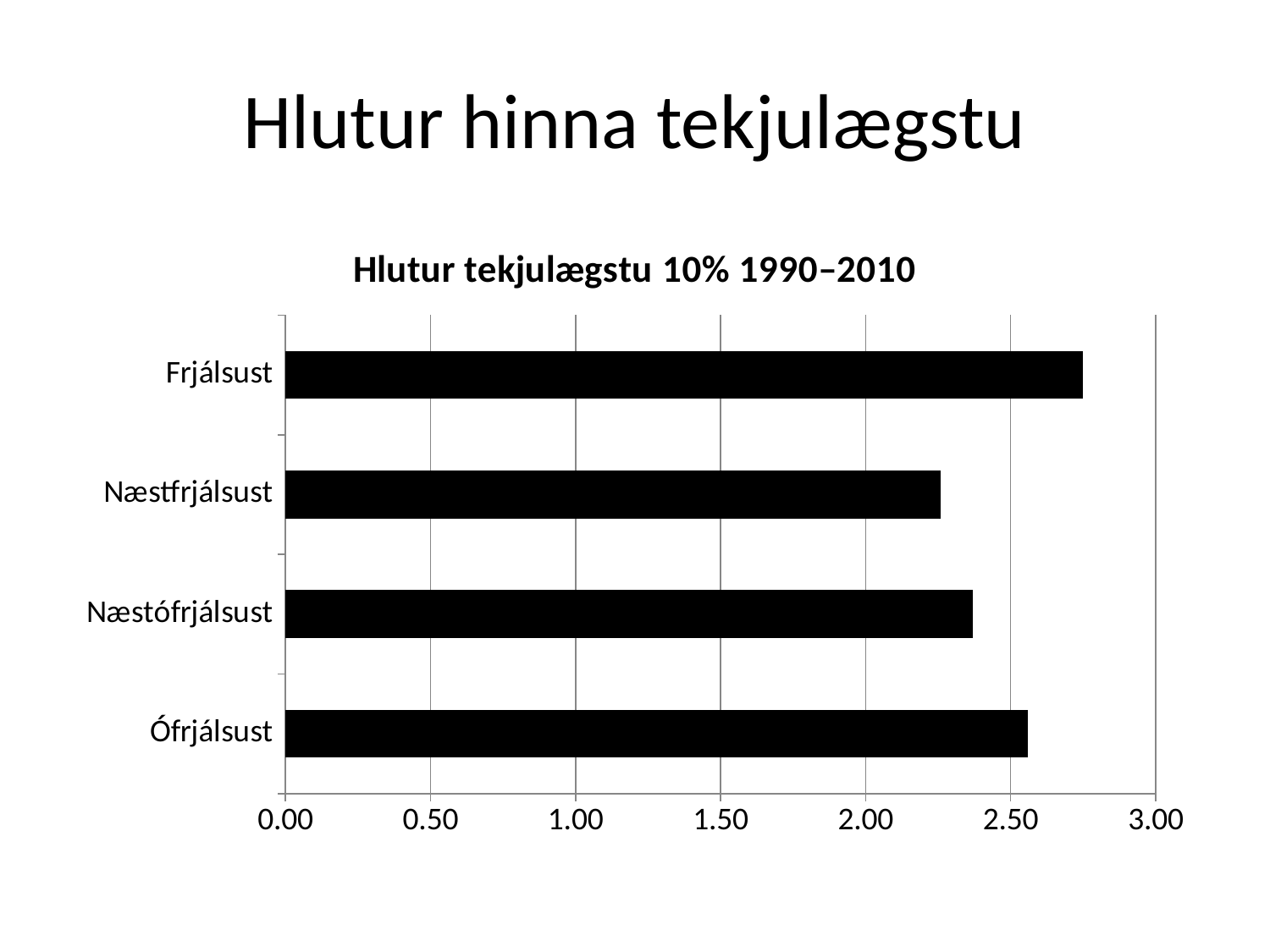
Which category has the lowest value? Næstfrjálsust Is the value for Ófrjálsust greater or less than 2.00? greater Is the value for Næstófrjálsust greater or less than 2.50? less What is the title of the chart? Hlutur tekjulægstu 10% 1990–2010 Which is larger, the value for Frjálsust or the value for Ófrjálsust? Frjálsust What kind of chart is shown on the slide? bar chart Is the value for Næstfrjálsust greater or less than 2.00? greater Which is larger, the value for Næstófrjálsust or the value for Næstfrjálsust? Næstófrjálsust Which category has the highest value? Frjálsust How many categories are shown in the chart? 4